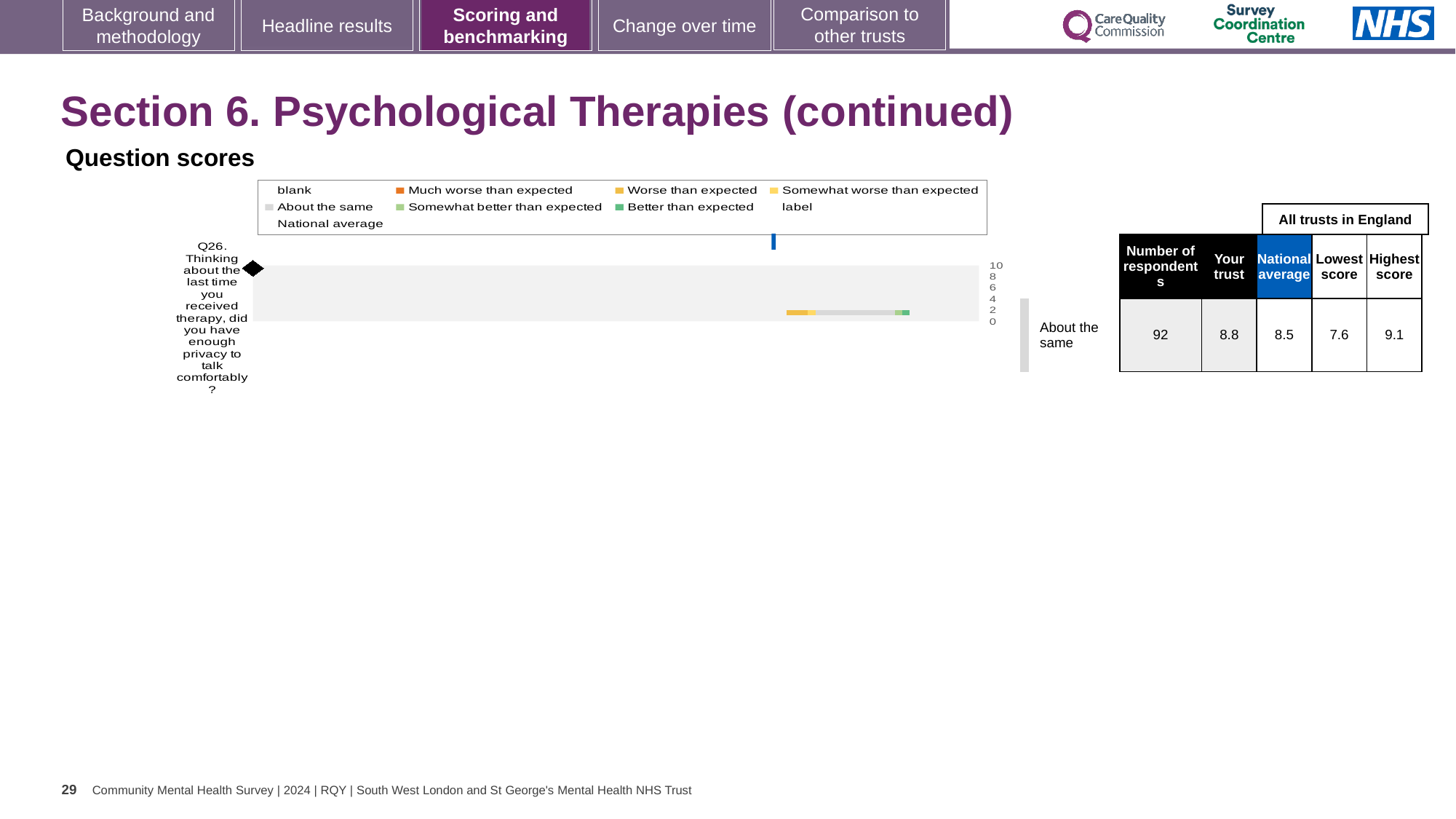
For Q26, what is the difference between the highest score and the lowest score among all trusts in England? 1.5 In the table beside the chart, what is the lowest score among all trusts in England for Q26? 7.6 In the table beside the chart, what is the national average score for Q26? 8.5 What kind of chart is shown under 'Question scores'? bar chart What is the highest value shown on the chart's axis? 10 Which question number is plotted in the chart? Q26 In the table beside the chart, how many respondents answered Q26? 92 What benchmark category is shown next to the chart for Q26? About the same For Q26, which is larger: the 'Your trust' score or the national average? Your trust In the table beside the chart, what is the 'Your trust' score for Q26? 8.8 How many survey questions are plotted in the chart? 1 In the table beside the chart, what is the highest score among all trusts in England for Q26? 9.1